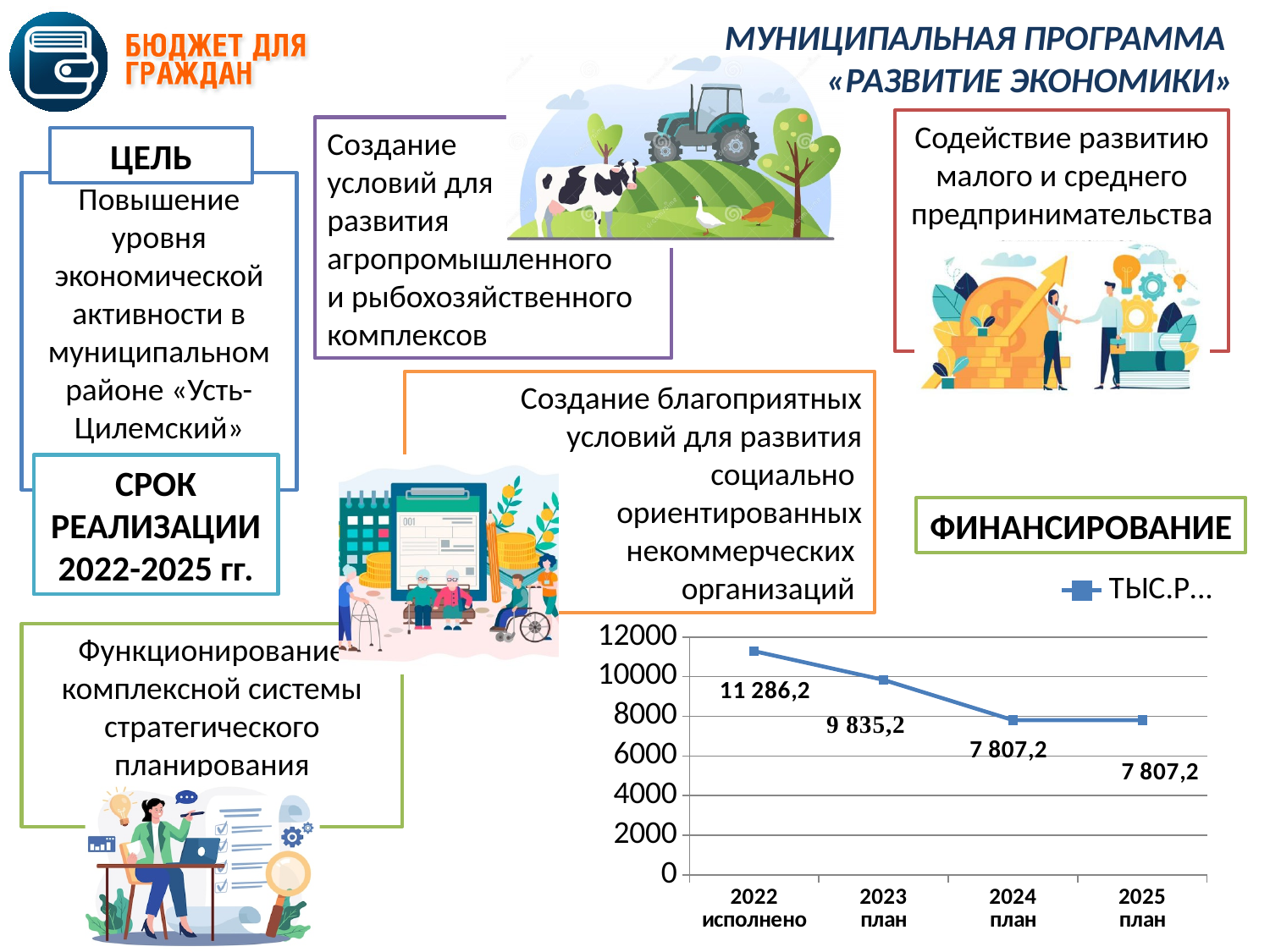
What is the value for 2022 исполнено in the financing chart? 11 286,2 Which year has the highest value in the financing chart? 2022 исполнено What is the value for 2023 план in the financing chart? 9 835,2 What is the value for 2024 план in the financing chart? 7 807,2 What is the value for 2025 план in the financing chart? 7 807,2 What type of chart is shown under the heading ФИНАНСИРОВАНИЕ? line chart How many data points are plotted in the financing chart? 4 What is the difference between the values for 2023 план and 2024 план in the financing chart? 2 028,0 Which is larger in the financing chart, the value for 2022 исполнено or the value for 2024 план? 2022 исполнено Do the values in the financing chart rise or fall from 2022 to 2024? fall Is the value for 2023 план in the financing chart greater or less than 10000? less What is the difference between the values for 2022 исполнено and 2023 план in the financing chart? 1 451,0